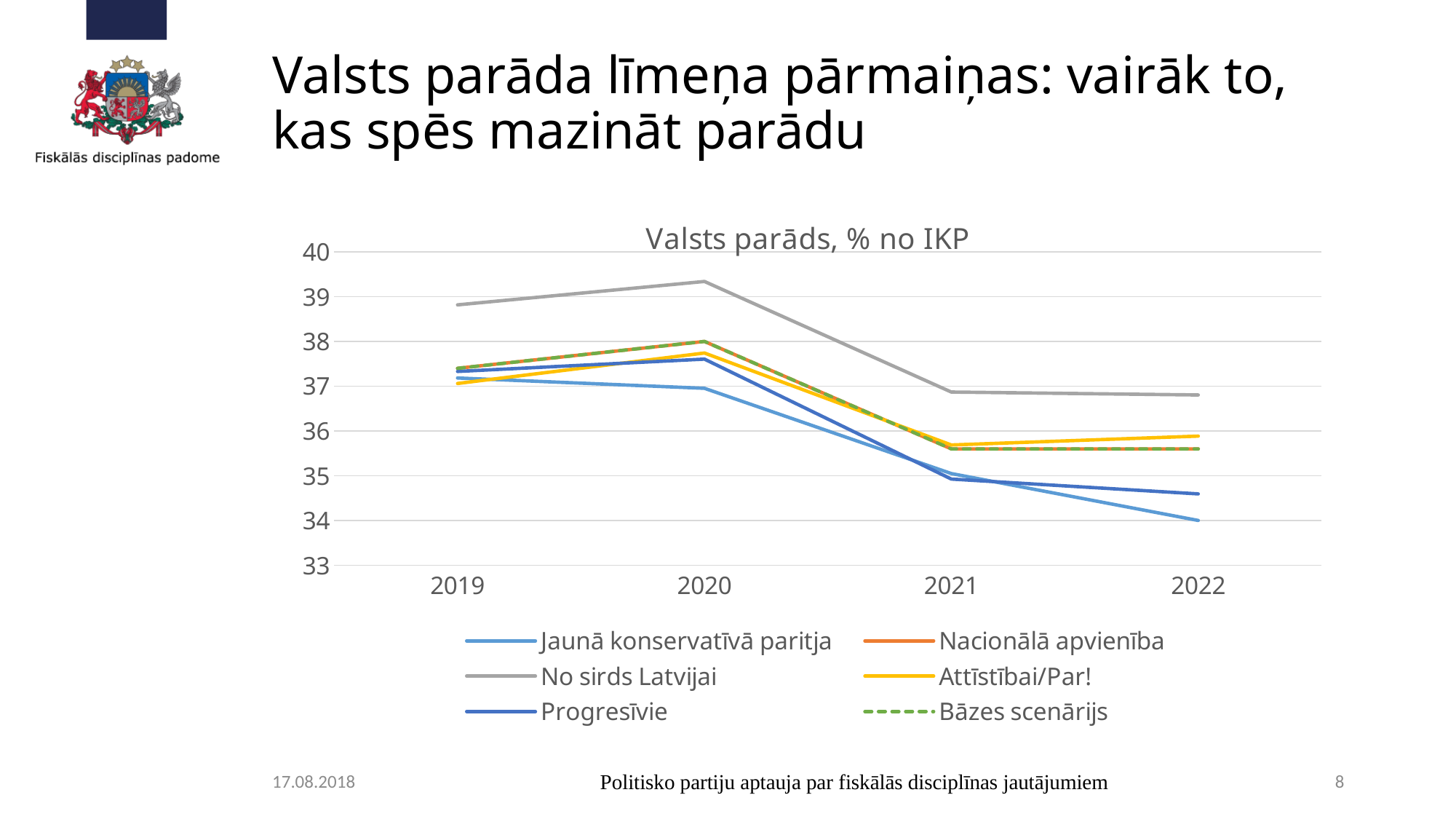
Which series has the highest value in 2019? No sirds Latvijai Is the value for Progresīvie in 2022 greater or less than 35? less What is the title of the chart? Valsts parāds, % no IKP In 2021, which is larger: the value for No sirds Latvijai or the value for Progresīvie? No sirds Latvijai How many series does the legend list? 6 Which series has the lowest value in 2022? Jaunā konservatīvā paritja Which series has the highest value in 2022? No sirds Latvijai Is the value for No sirds Latvijai in 2020 greater or less than 39? greater Is the value for Jaunā konservatīvā paritja in 2022 greater or less than 35? less What kind of chart is shown on the slide? line chart Does the value for No sirds Latvijai rise or fall from 2020 to 2022? fall How many years are shown on the x axis? 4